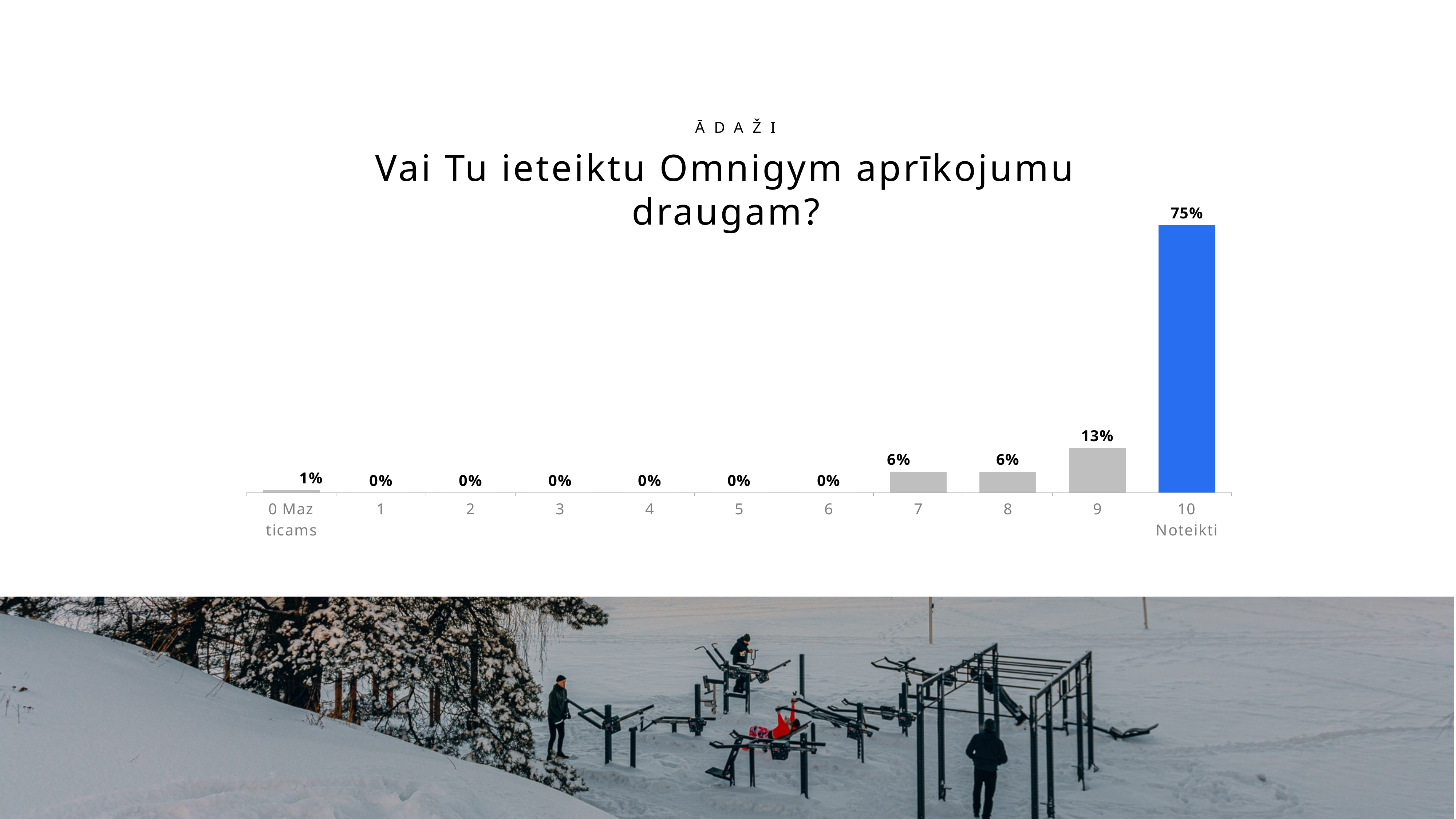
What is the difference between the values for "10 Noteikti" and category 9? 62% What is the value for the "0 Maz ticams" category? 1% What is the value for category 7? 6% What is the difference between the values for category 9 and category 8? 7% Which category has the highest value? 10 Noteikti What is the value for category 9? 13% Which is larger, the value for category 9 or the value for category 7? Category 9 What kind of chart is shown on the slide? Bar chart What is the title of the chart? Vai Tu ieteiktu Omnigym aprīkojumu draugam? How many categories have a value of 0%? 6 What is the value for the "10 Noteikti" category? 75% How many categories are shown on the x axis? 11